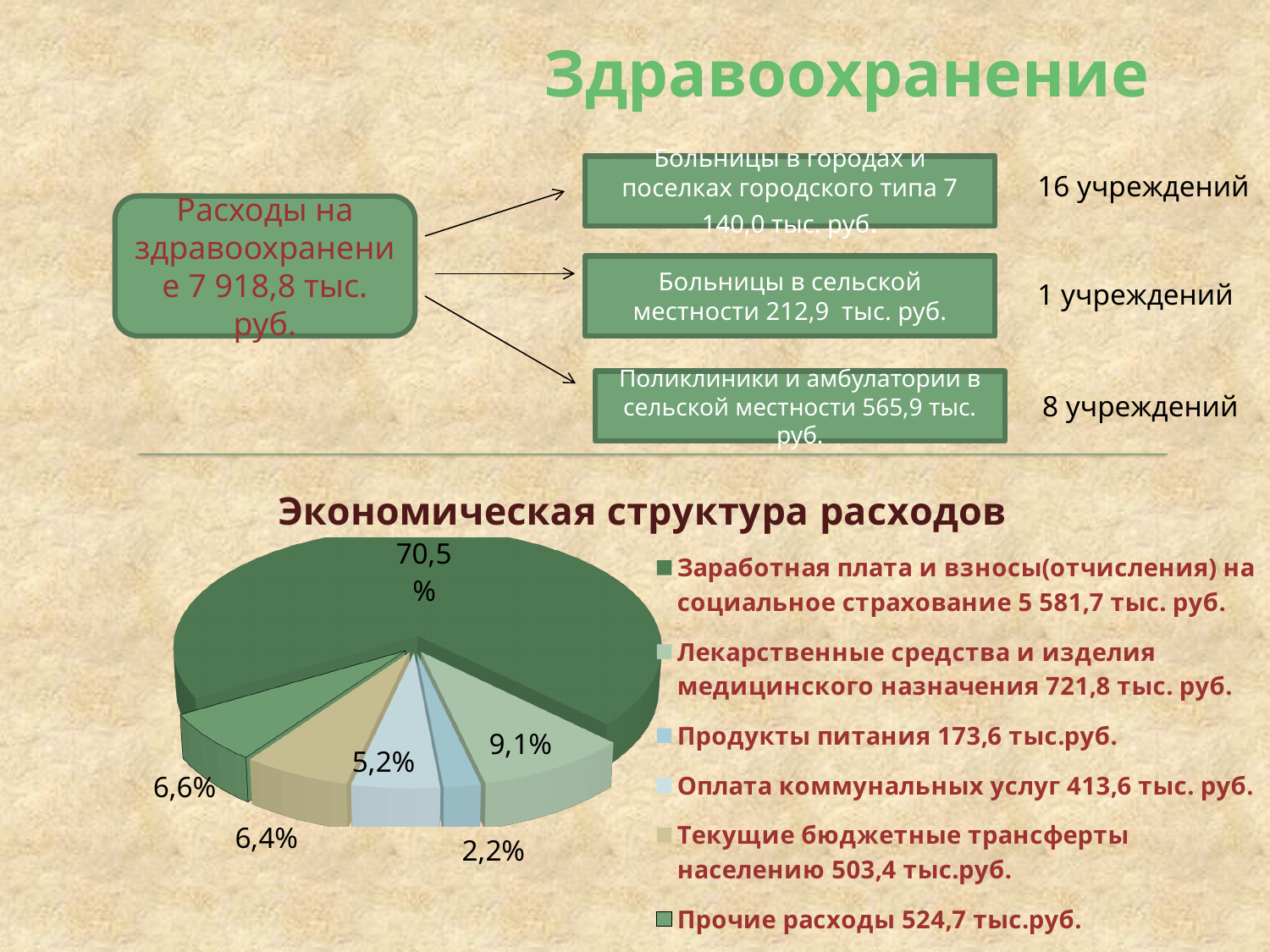
What share of the pie does "Заработная плата и взносы(отчисления) на социальное страхование" take? 70,5% What amount in тыс. руб. does the legend give for "Оплата коммунальных услуг"? 413,6 тыс. руб. What is the title of the pie chart on the slide? Экономическая структура расходов What kind of chart is shown under the heading "Экономическая структура расходов"? pie chart Which category has the smallest share in the pie chart? Продукты питания Which is larger in the pie chart: the share for "Текущие бюджетные трансферты населению" or the share for "Оплата коммунальных услуг"? Текущие бюджетные трансферты населению What share of the pie does "Продукты питания" take? 2,2% How many entries does the legend of the pie chart list? 6 Which category has the largest share in the pie chart "Экономическая структура расходов"? Заработная плата и взносы(отчисления) на социальное страхование What share of the pie does "Лекарственные средства и изделия медицинского назначения" take? 9,1% What amount in тыс. руб. does the legend give for "Прочие расходы"? 524,7 тыс.руб. How many slices does the pie chart "Экономическая структура расходов" have? 6